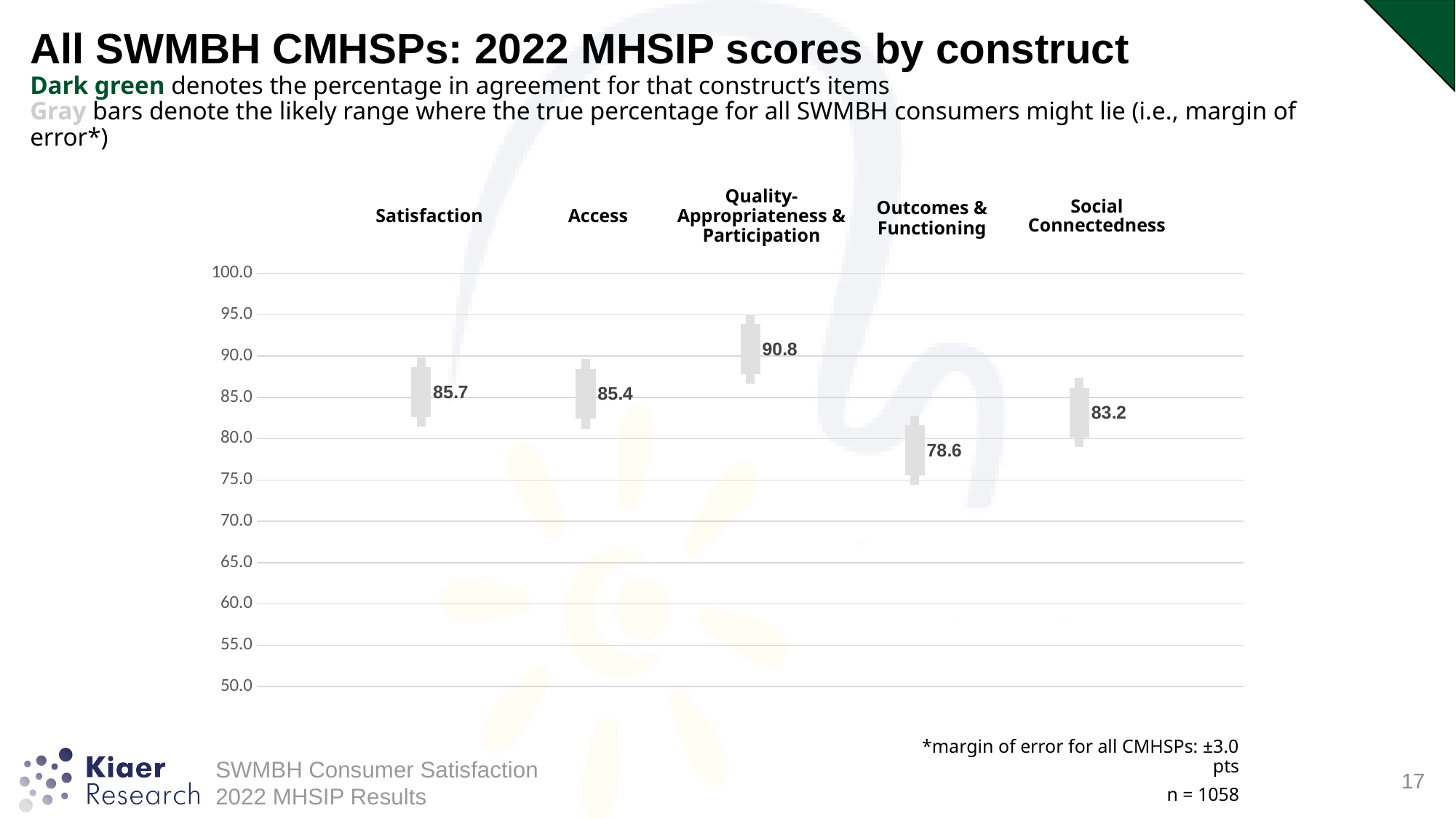
Is the score for Outcomes & Functioning greater or less than 80.0? less What is the difference between the Quality-Appropriateness & Participation score and the Outcomes & Functioning score? 12.2 Which construct has the lowest score? Outcomes & Functioning What is the score for Social Connectedness? 83.2 What is the score for Quality-Appropriateness & Participation? 90.8 What is the score for Outcomes & Functioning? 78.6 Which has the higher score, Satisfaction or Access? Satisfaction How many constructs are plotted on the chart? 5 What is the 2022 MHSIP score for Satisfaction? 85.7 Which construct has the highest score? Quality-Appropriateness & Participation What is the score shown for Access? 85.4 What margin of error is stated for all CMHSPs in the chart footnote? ±3.0 pts